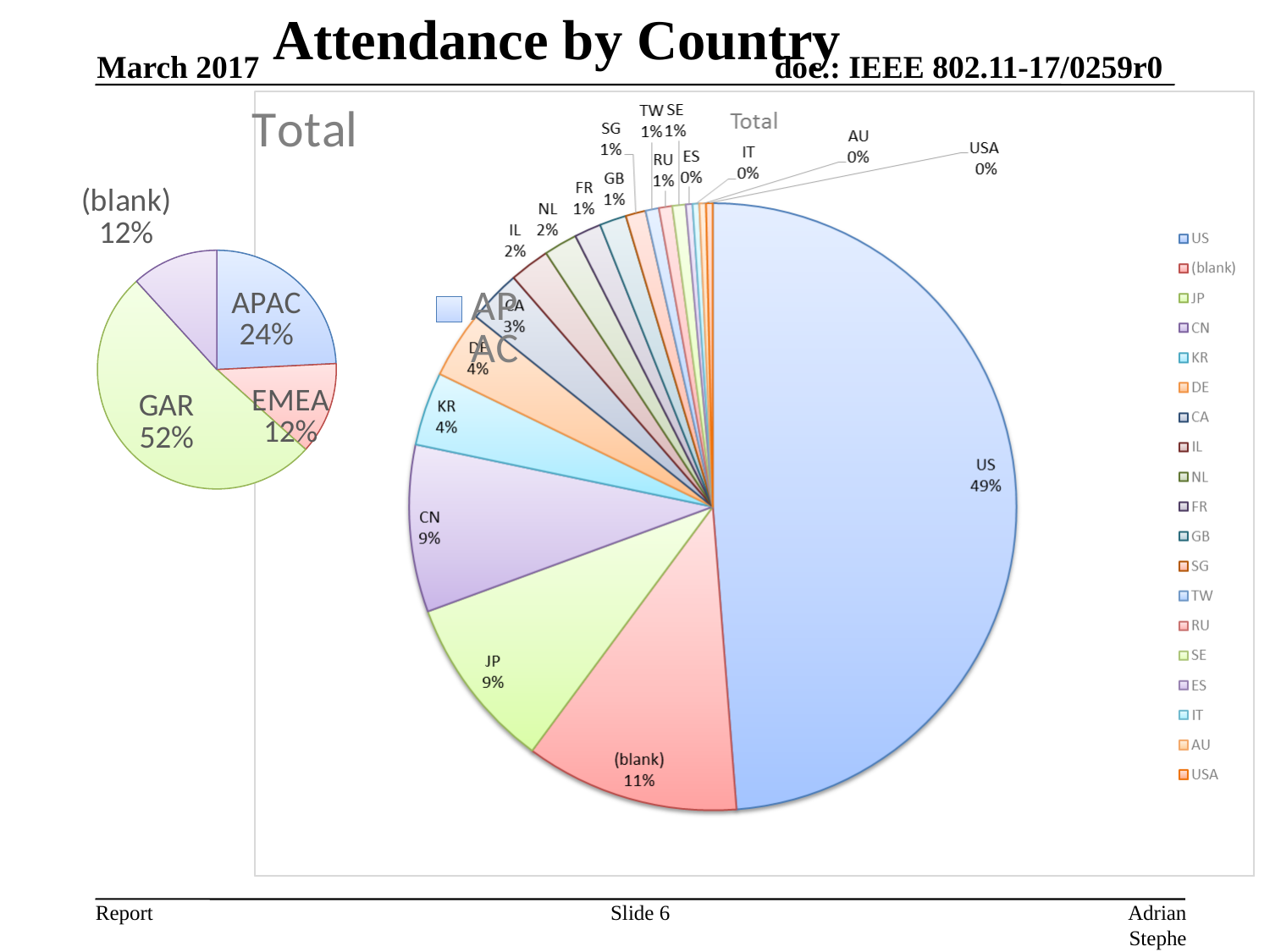
In the large pie chart on the right, how many entries does the legend list? 19 In the small pie chart on the left, what share does APAC have? 24% In the small pie chart on the left, which region has the largest share? GAR In the small pie chart on the left, what share does GAR have? 52% In the large pie chart on the right, what share does US have? 49% What kind of chart is the large chart on the right? Pie chart In the large pie chart on the right, which is larger, the share for CN or the share for CA? CN In the large pie chart on the right, which country has the largest share? US In the large pie chart on the right, what share does KR have? 4% In the large pie chart on the right, what share does (blank) have? 11% In the small pie chart on the left, what is the difference between the GAR share and the EMEA share? 40% In the large pie chart on the right, what is the difference between the US share and the (blank) share? 38%